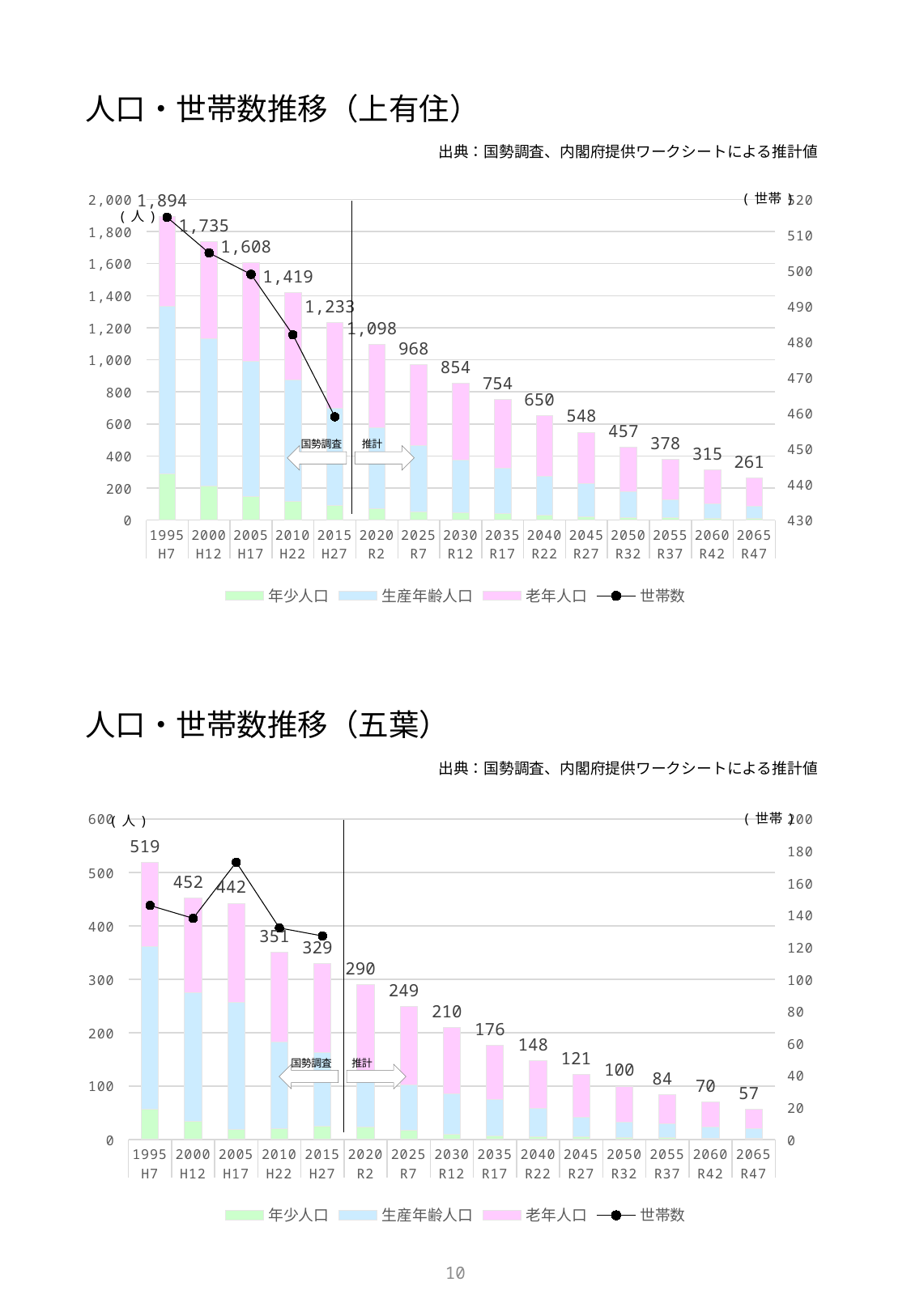
In the 人口・世帯数推移（五葉） chart, what is the total population labelled for 2030 (R12)? 210 In the 人口・世帯数推移（上有住） chart, what is the difference between the labelled totals for 1995 and 2065? 1,633 How many series does the legend of the 人口・世帯数推移（上有住） chart list? 4 In the 人口・世帯数推移（上有住） chart, what is the total population labelled for 2015 (H27)? 1,233 In the 人口・世帯数推移（上有住） chart, is the 世帯数 value for 2015 greater or less than 470 on the right axis? less In the 人口・世帯数推移（上有住） chart, which year has the highest labelled total population? 1995 (H7) In the 人口・世帯数推移（五葉） chart, do the labelled total population values rise or fall from 1995 to 2065? fall In the 人口・世帯数推移（上有住） chart, which is larger: the labelled total for 2040 or for 2045? 2040 In the 人口・世帯数推移（五葉） chart, which year has the lowest labelled total population? 2065 (R47) How many years are shown on the x axis of the 人口・世帯数推移（五葉） chart? 15 In the 人口・世帯数推移（五葉） chart, is the 世帯数 value for 2005 greater or less than 160 on the right axis? greater In the 人口・世帯数推移（五葉） chart, what is the difference between the labelled totals for 2020 and 2025? 41